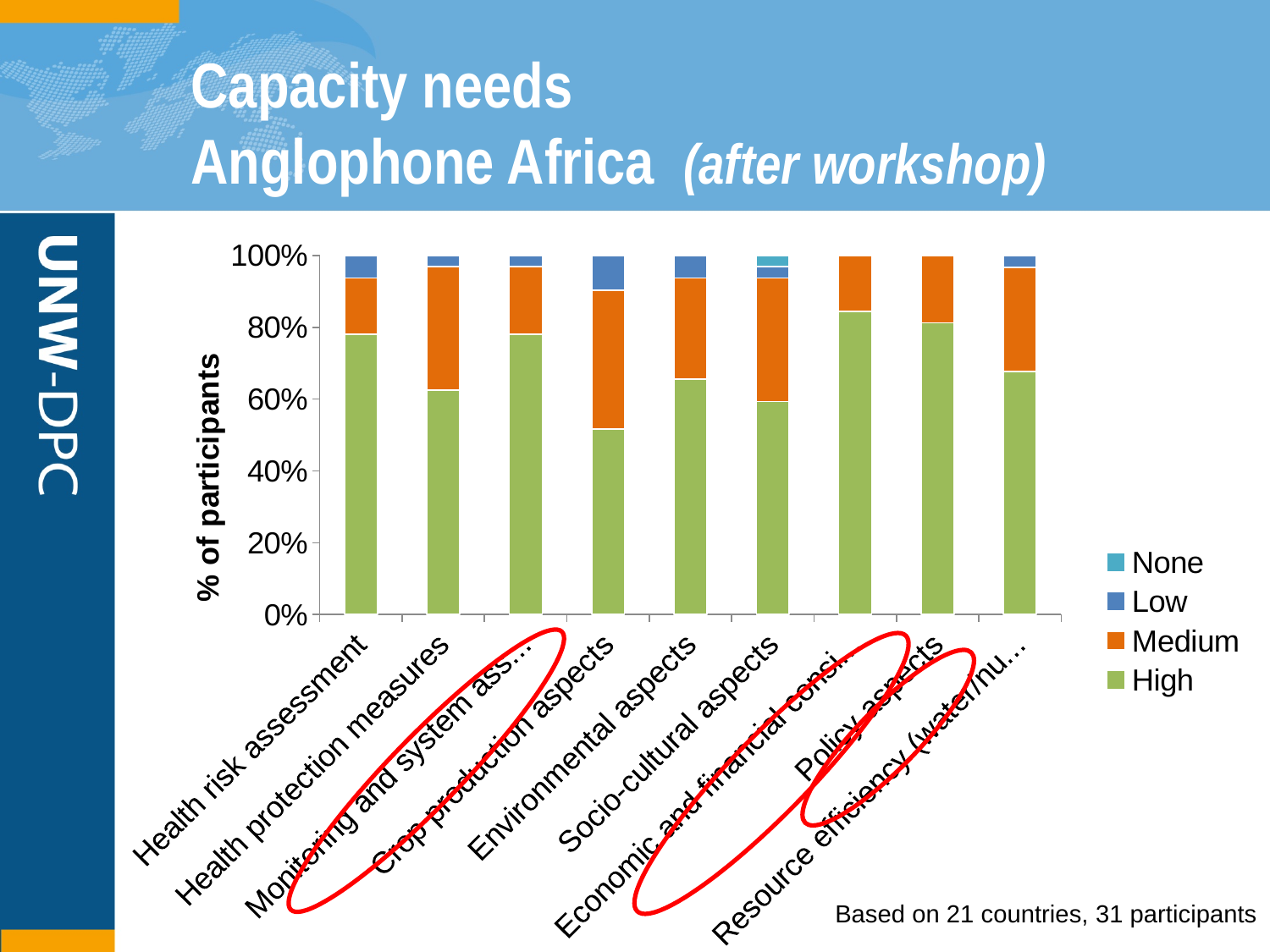
What kind of chart is shown on the slide? Stacked bar chart Is the High share for Health risk assessment greater or less than 60%? greater Is the High share for Resource efficiency greater or less than 80%? less How many series does the legend list? 4 Which category is the only one with a visible None segment? Socio-cultural aspects Is the High share for Crop production aspects greater or less than 60%? less What is the title of the slide? Capacity needs Anglophone Africa (after workshop) What is the label of the y axis? % of participants How many categories are plotted along the x axis? 9 Which category has the lowest share of participants rating the need as High? Crop production aspects Which has a larger High share: Socio-cultural aspects or Policy aspects? Policy aspects Which has a larger High share: Health risk assessment or Crop production aspects? Health risk assessment